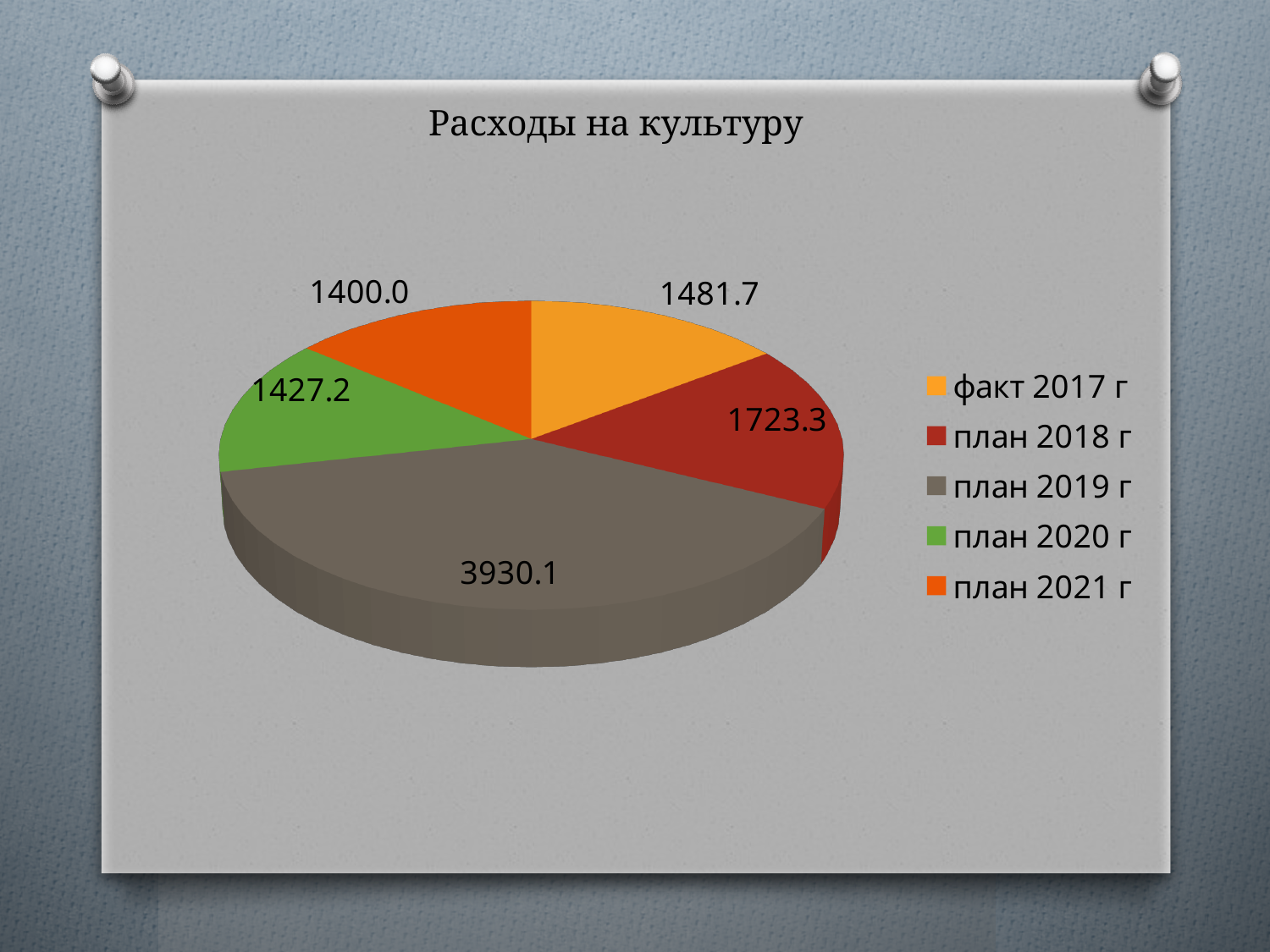
Which category has the largest slice? план 2019 г How many slices does the pie chart have? 5 Which category has the smallest slice? план 2021 г What is the total of all slices in the pie chart? 9962.3 What is the value for план 2019 г? 3930.1 What is the value for факт 2017 г? 1481.7 What is the title of the chart? Расходы на культуру What is the difference between план 2019 г and план 2018 г? 2206.8 What type of chart is shown on the slide? Pie chart What is the value for план 2021 г? 1400.0 Which colour represents план 2020 г in the legend? Green Which is larger, план 2018 г or факт 2017 г? план 2018 г